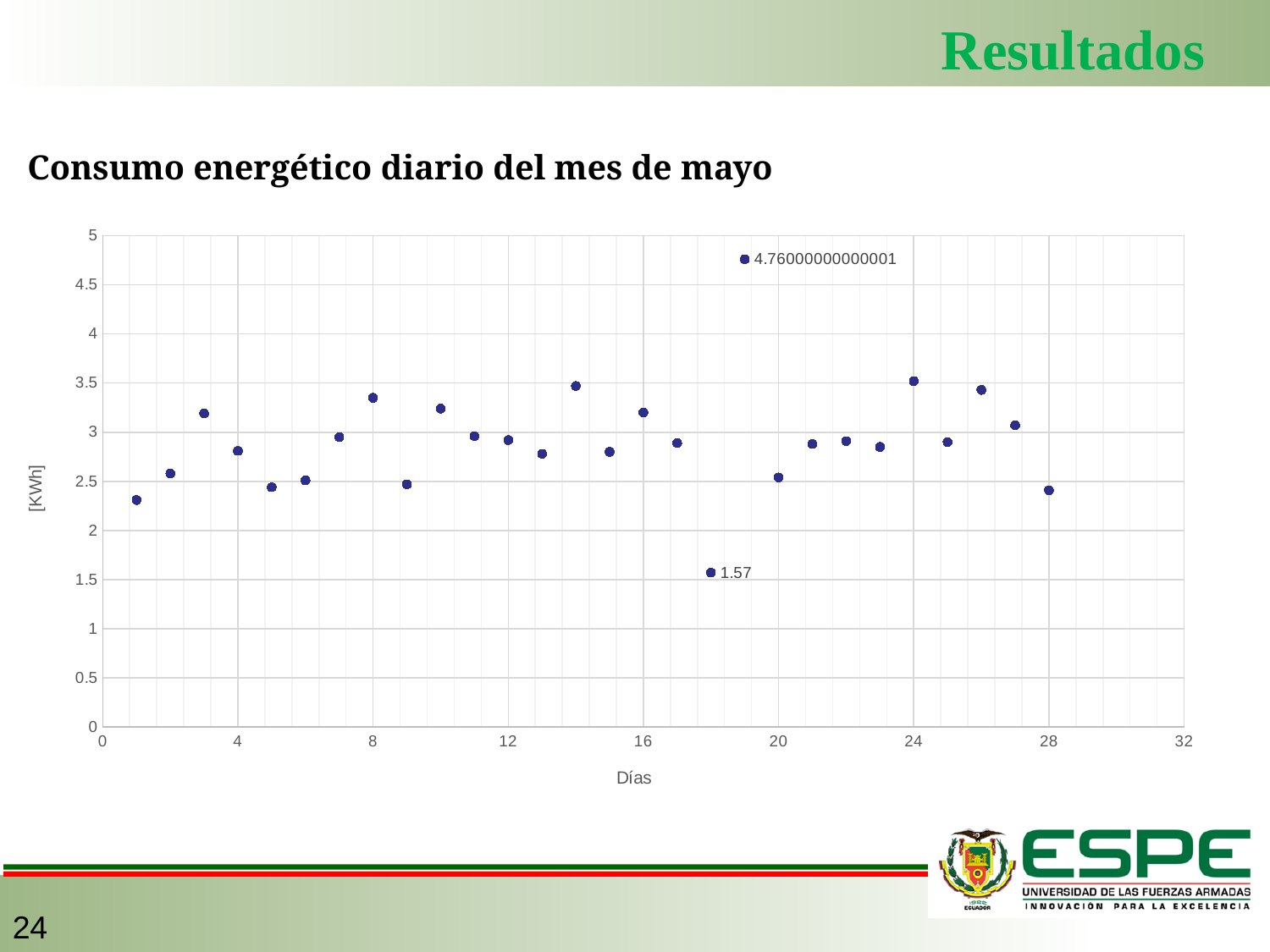
What kind of chart is shown on the slide? scatter chart What is the label of the y axis? [KWh] What is the value of the labeled point on day 19? 4.76000000000001 On which day is the energy consumption lowest? 18 What is the value of the labeled point on day 18? 1.57 How many data points are plotted on the chart? 28 What is the title of the chart? Consumo energético diario del mes de mayo Is the value for day 28 greater or less than 2.5? less Is the value for day 8 greater or less than 3? greater Is the value for day 1 greater or less than 2.5? less Which day has the higher value, day 3 or day 4? day 3 On which day is the energy consumption highest? 19